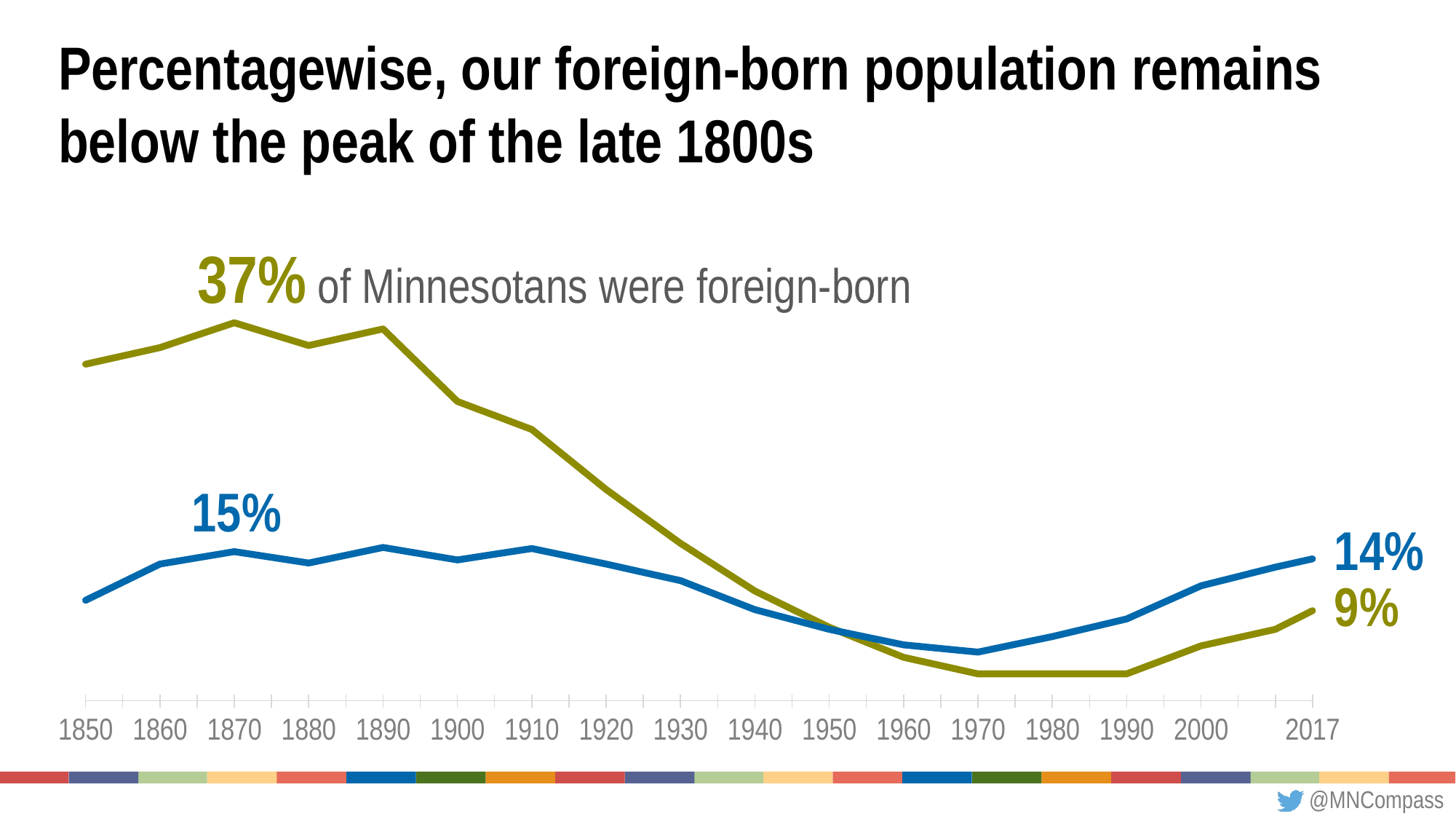
How many years are labelled on the x axis? 17 Does the olive (Minnesota) line rise or fall between 1890 and 1970? fall In 1870, which line is higher, the olive line or the blue line? the olive line What kind of chart is shown on the slide? line chart What value does the olive (Minnesota) line show for 2017? 9% In 2017, what is the difference between the blue line (14%) and the olive line (9%)? 5 percentage points What percentage of Minnesotans were foreign-born at the 1870 peak of the olive line? 37% In 2017, which line is higher, the olive line or the blue line? the blue line What value is labelled on the blue line in 1870? 15% What value is labelled on the blue line in 2017? 14% By how many percentage points did the olive (Minnesota) line fall from its 1870 peak of 37% to 9% in 2017? 28 percentage points In which year does the olive (Minnesota) line reach its highest value? 1870